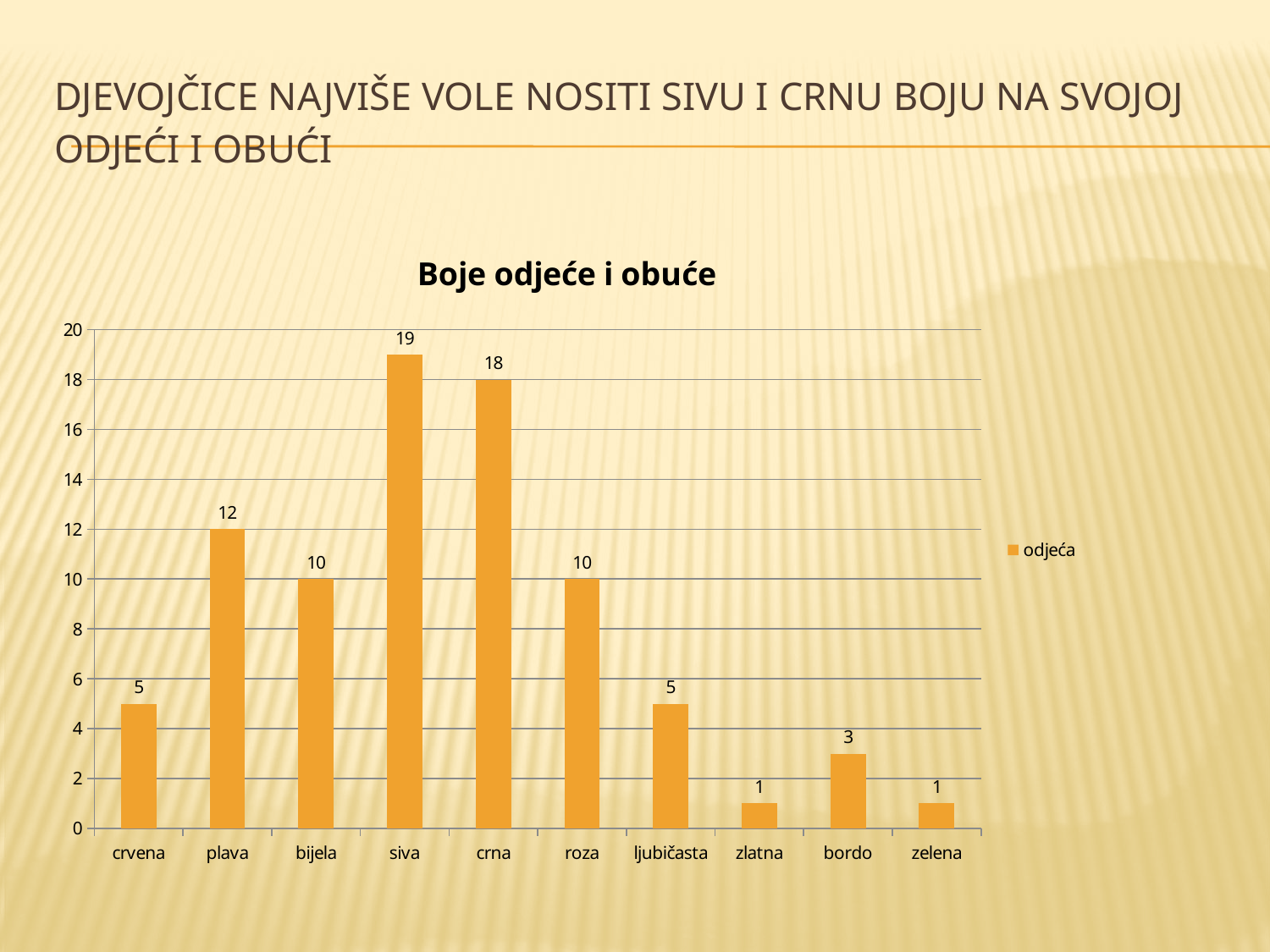
How many categories are shown on the x axis? 10 What is the value for plava? 12 What is the difference between the values for siva and crna? 1 What is the title of the chart? Boje odjeće i obuće Which is larger, the value for roza or the value for ljubičasta? roza What kind of chart is shown? bar chart Is the value for crna greater or less than 16? greater What is the difference between the values for plava and crvena? 7 What is the value for siva? 19 Which category has the highest value? siva What is the value for bordo? 3 How many series does the legend list? 1